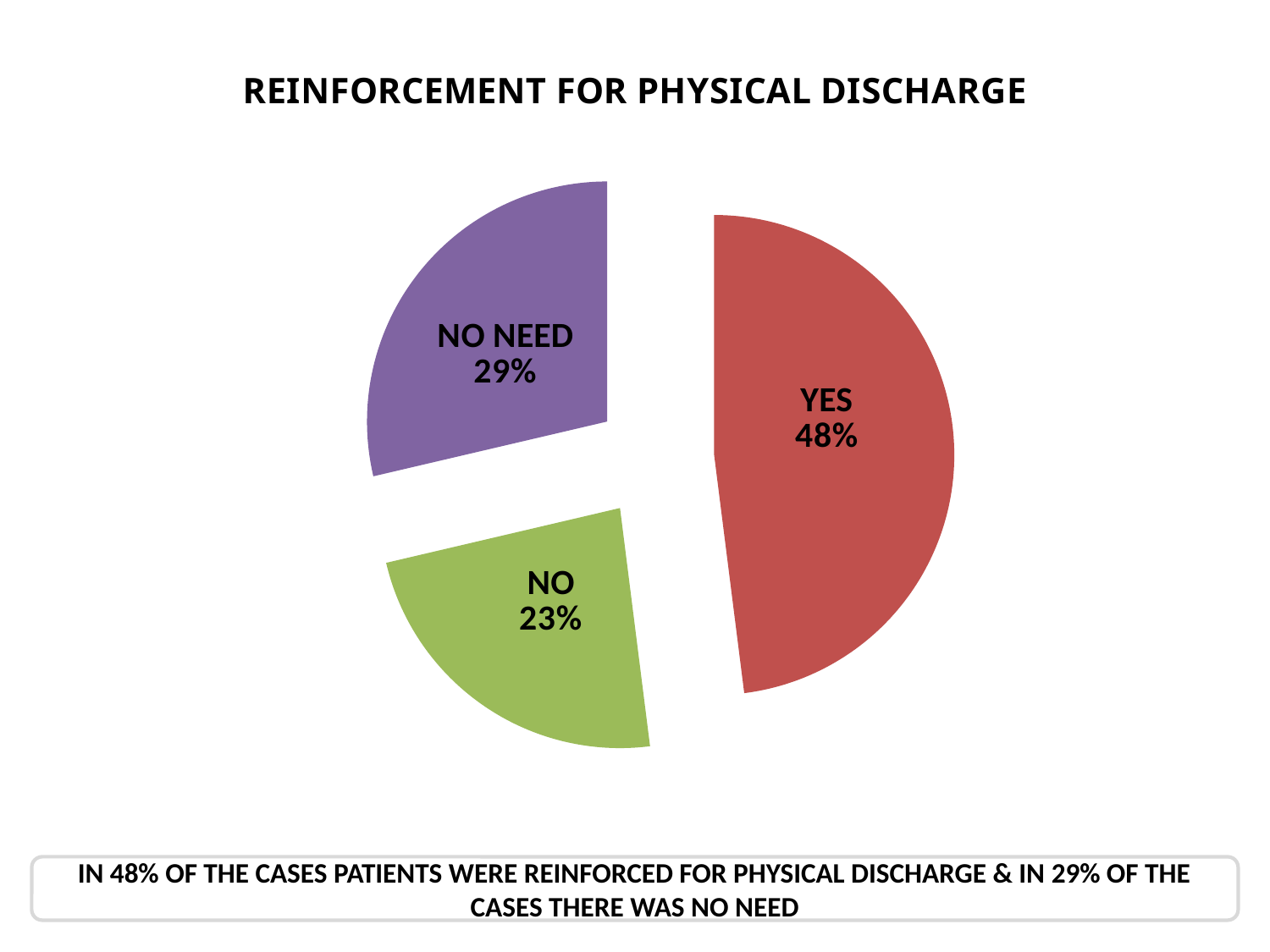
What percentage of cases is labelled NO NEED? 29% Which is larger, the NO NEED slice or the NO slice? NO NEED What is the title of the chart? REINFORCEMENT FOR PHYSICAL DISCHARGE What percentage of cases is labelled NO? 23% Which slice of the pie is the largest? YES How many slices does the pie chart have? 3 What kind of chart is shown on the slide? pie chart What is the difference in percentage points between the NO NEED and NO slices? 6 What is the difference in percentage points between the YES and NO slices? 25 What colour is the YES slice? red What percentage of cases is labelled YES? 48% Which slice of the pie is the smallest? NO